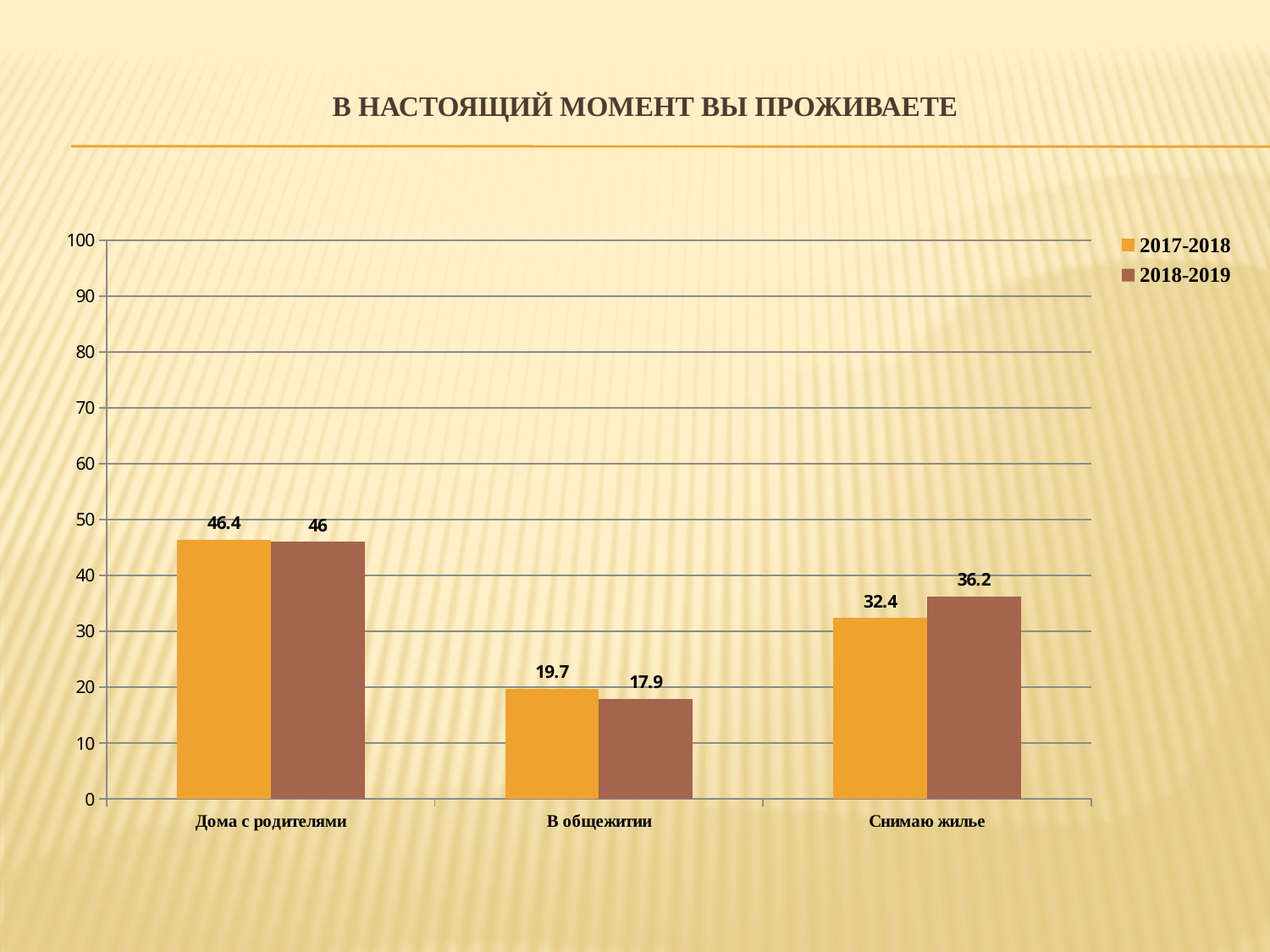
For "Снимаю жилье", which series has the larger value, 2017-2018 or 2018-2019? 2018-2019 What is the value for "В общежитии" in the 2018-2019 series? 17.9 Which category has the lowest value in the 2017-2018 series? В общежитии What is the value for "Дома с родителями" in the 2017-2018 series? 46.4 What is the difference between the 2018-2019 and 2017-2018 values for "Снимаю жилье"? 3.8 Is the 2018-2019 value for "Дома с родителями" greater or less than 40? greater What is the difference between the 2017-2018 and 2018-2019 values for "В общежитии"? 1.8 What is the value for "Снимаю жилье" in the 2017-2018 series? 32.4 What kind of chart is shown on the slide? bar chart Which category has the highest value in the 2018-2019 series? Дома с родителями How many categories are shown on the x axis? 3 How many series does the legend list? 2